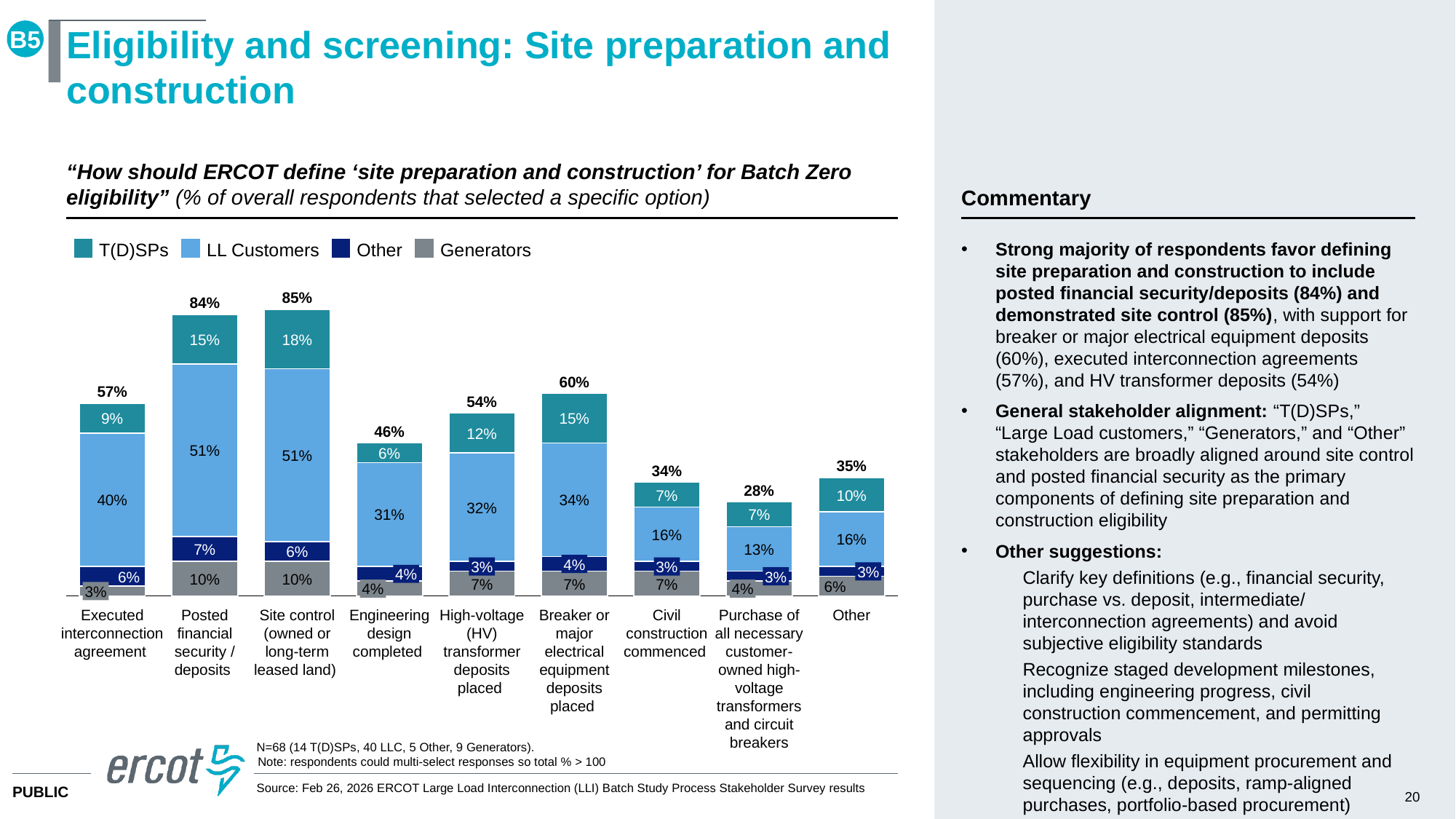
What are the four series named in the chart legend? T(D)SPs, LL Customers, Other, Generators What kind of chart is shown on the slide? Stacked bar chart What is the difference between the overall total for 'Posted financial security / deposits' and the overall total for 'Civil construction commenced'? 50 percentage points Which response option has the lowest overall percentage of respondents? Purchase of all necessary customer-owned high-voltage transformers and circuit breakers, 28% How many response options (categories) are plotted along the x axis of the chart? 9 Which response option has the highest overall percentage of respondents? Site control (owned or long-term leased land), 85% Which has a larger LL Customers value: 'High-voltage (HV) transformer deposits placed' or 'Breaker or major electrical equipment deposits placed'? Breaker or major electrical equipment deposits placed (34%) How many series does the chart legend list? 4 What is the T(D)SPs value for 'Site control (owned or long-term leased land)'? 18% What percentage of LL Customers selected 'Engineering design completed'? 31% What is the Generators value for the 'Other' response option? 6% What is the overall total shown above the bar for 'Breaker or major electrical equipment deposits placed'? 60%